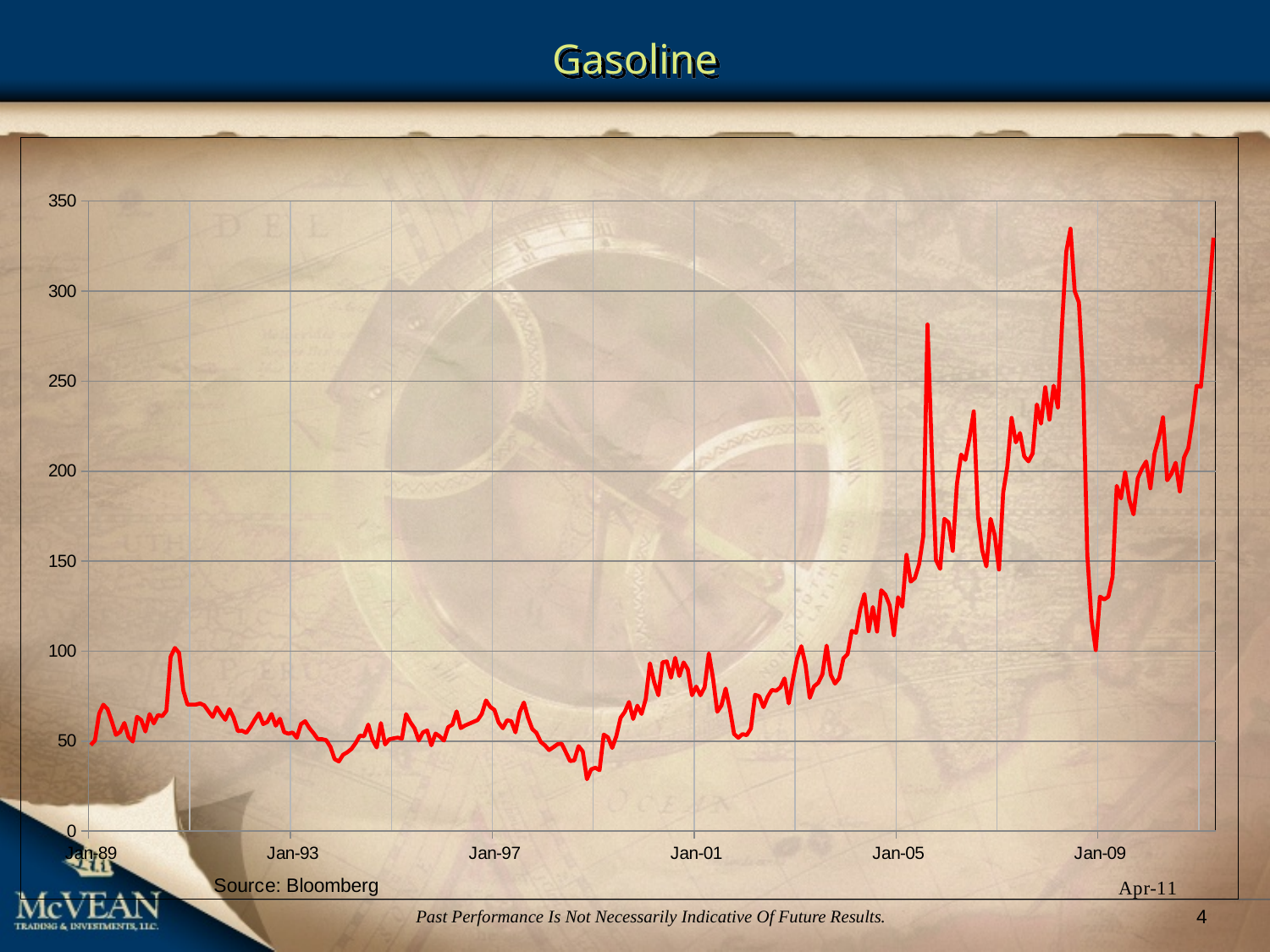
Is the value at Jan-01 greater or less than 100? less How many date labels are shown on the x axis? 6 Overall, does the gasoline line rise or fall from Jan-89 to the end of the chart? rise What kind of chart is shown on the slide? line chart Is the value at Jan-97 greater or less than 100? less What source is cited for the chart data? Bloomberg What is the title of the chart? Gasoline What is the highest value shown on the y axis? 350 How many lines are plotted on the chart? 1 Does the line reach its highest point before or after Jan-05? after Is the highest peak of the line greater or less than 300? greater